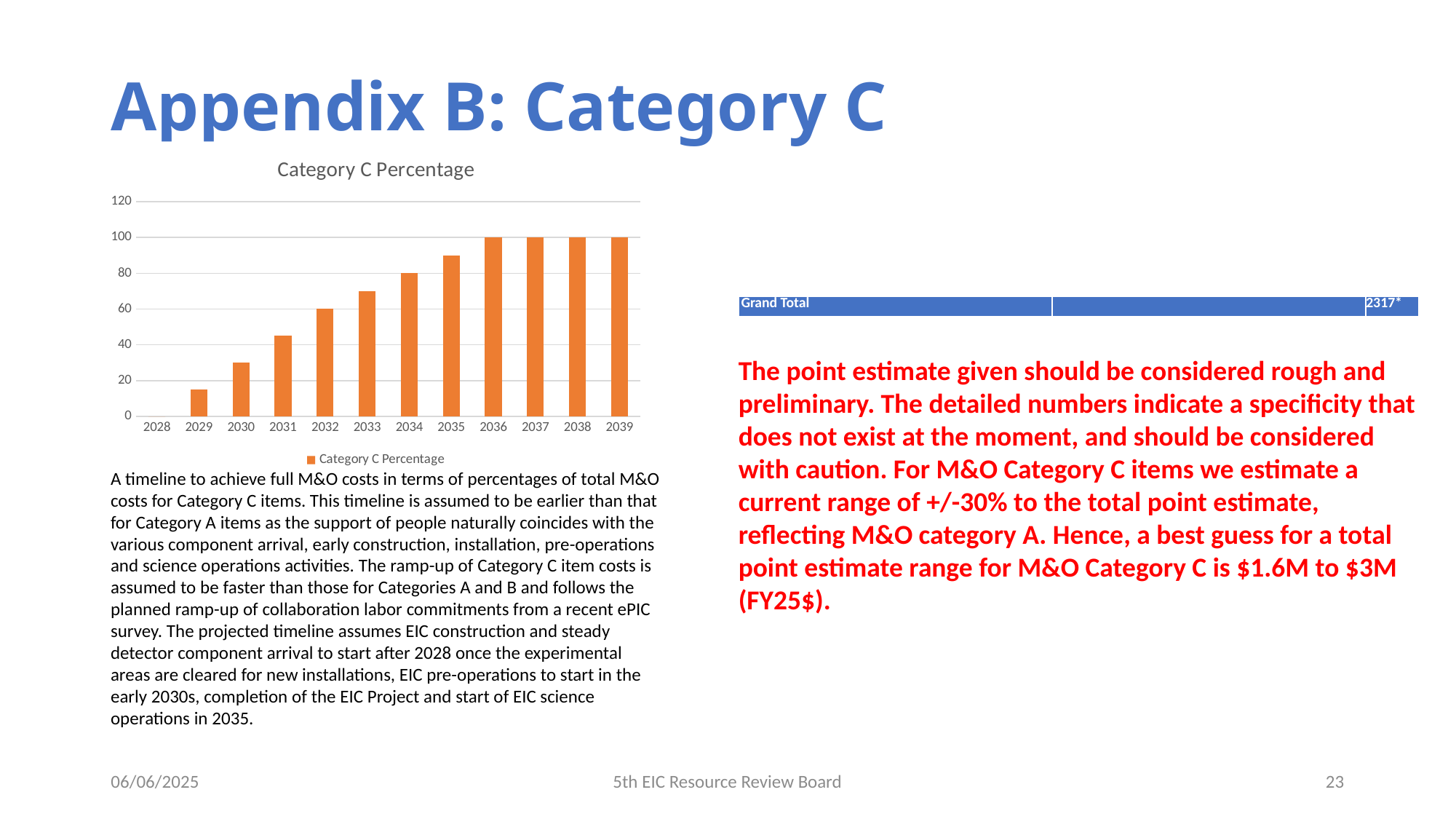
What type of chart is shown on the slide? bar chart What is the Category C Percentage value for 2034? 80 Is the value for 2029 greater or less than 20? less Is the value for 2031 greater or less than 40? greater What is the title of the chart? Category C Percentage Is the value for 2035 greater or less than 80? greater Which year has the lowest Category C Percentage? 2028 What is the difference between the values for 2034 and 2032? 20 How many series does the chart legend list? 1 What is the Category C Percentage value for 2036? 100 How many years are shown on the x axis of the chart? 12 What is the Category C Percentage value for 2032? 60